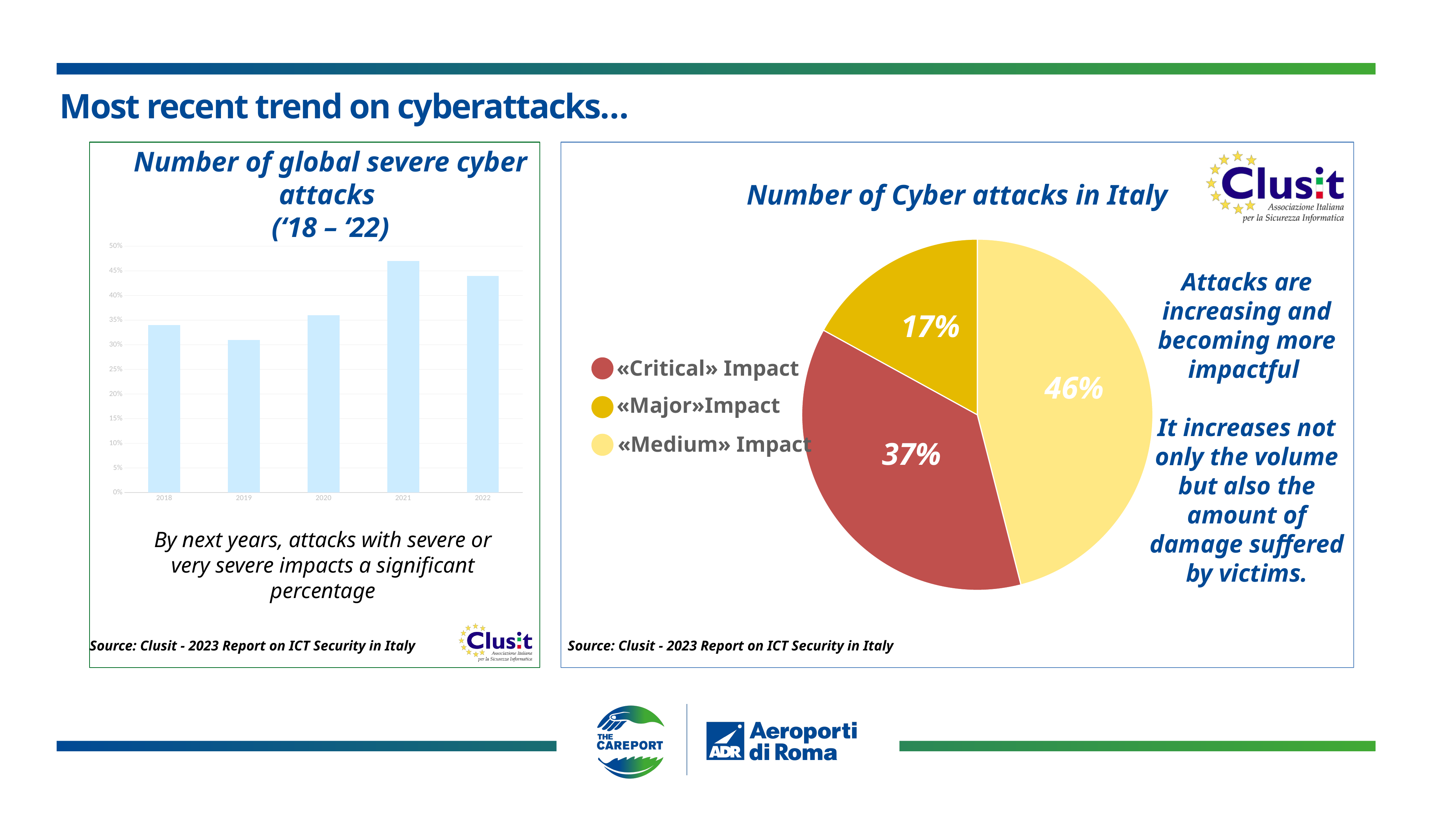
In the 'Number of Cyber attacks in Italy' pie chart, what share is labelled for «Major» Impact? 17% In the 'Number of Cyber attacks in Italy' pie chart, what is the difference between the «Medium» Impact share and the «Critical» Impact share? 9% In the 'Number of Cyber attacks in Italy' pie chart, which impact category has the smallest slice? «Major» Impact In the 'Number of global severe cyber attacks ('18 – '22)' chart, is the value for 2021 greater or less than 45%? greater In the 'Number of Cyber attacks in Italy' pie chart, what share is labelled for «Critical» Impact? 37% How many years are shown on the x axis of the 'Number of global severe cyber attacks ('18 – '22)' chart? 5 How many categories does the legend of the 'Number of Cyber attacks in Italy' pie chart list? 3 In the 'Number of global severe cyber attacks ('18 – '22)' chart, is the value for 2019 greater or less than 35%? less In the 'Number of global severe cyber attacks ('18 – '22)' chart, which year has the lowest bar? 2019 In the 'Number of Cyber attacks in Italy' pie chart, which impact category has the largest slice? «Medium» Impact In the 'Number of global severe cyber attacks ('18 – '22)' chart, which year has the highest bar? 2021 What kind of chart is 'Number of global severe cyber attacks ('18 – '22)'? Bar chart